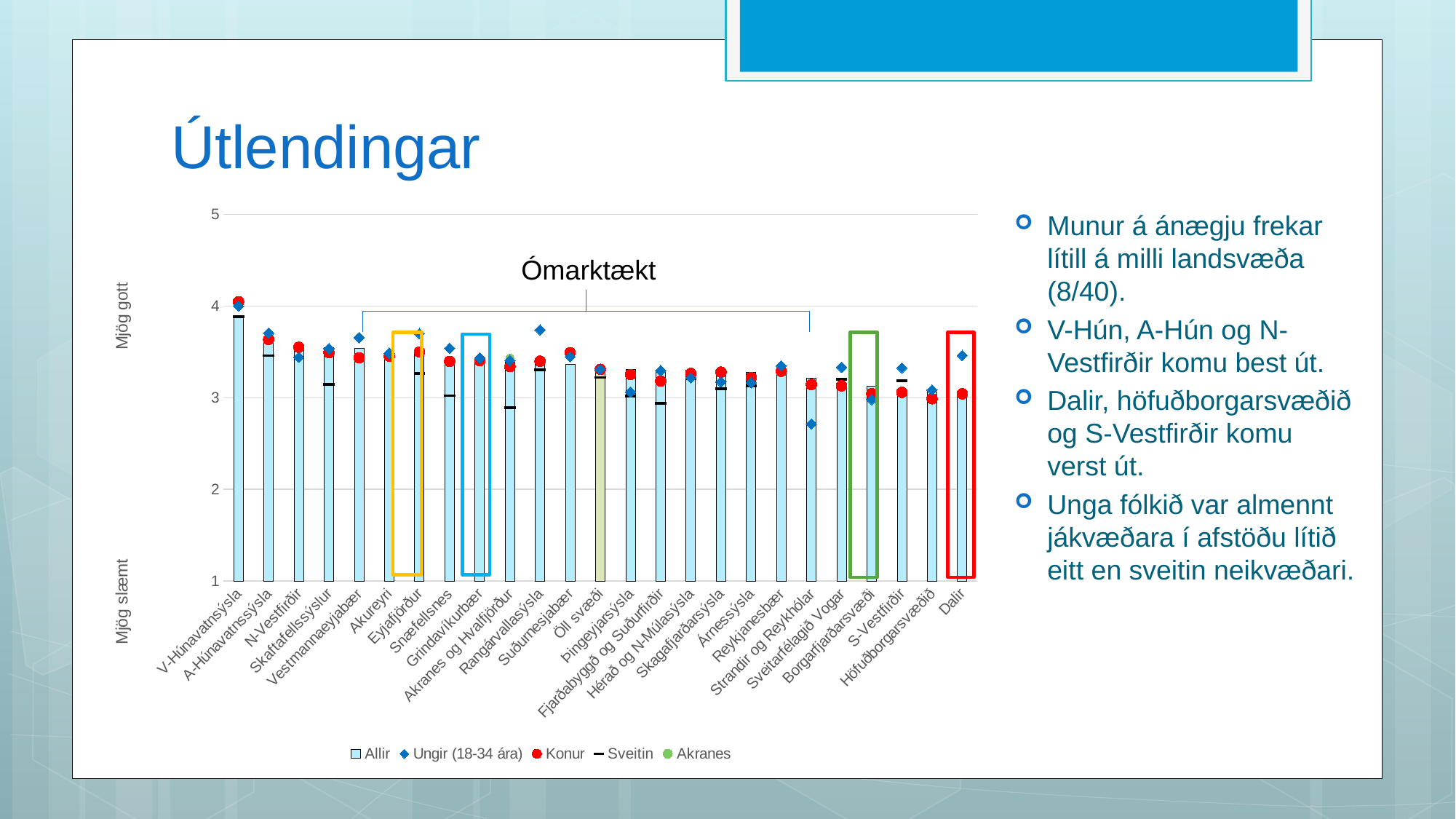
Is the Allir value for Dalir greater or less than 4? less What kind of chart is shown on the slide? bar chart What annotation text is written above the middle group of bars in the chart? Ómarktækt How many regions (categories) are plotted along the x axis? 25 Which region has the highest Allir bar? V-Húnavatnssýsla What label appears at the top of the y axis, next to the value 5? Mjög gott Do the Allir bars generally rise or fall from left to right along the x axis? fall Is the Ungir (18-34 ára) value for Strandir og Reykhólar greater or less than 3? less How many series does the chart legend list? 5 Is the Ungir (18-34 ára) value for Dalir greater or less than 3? greater Which has the larger Allir value, V-Húnavatnssýsla or Dalir? V-Húnavatnssýsla